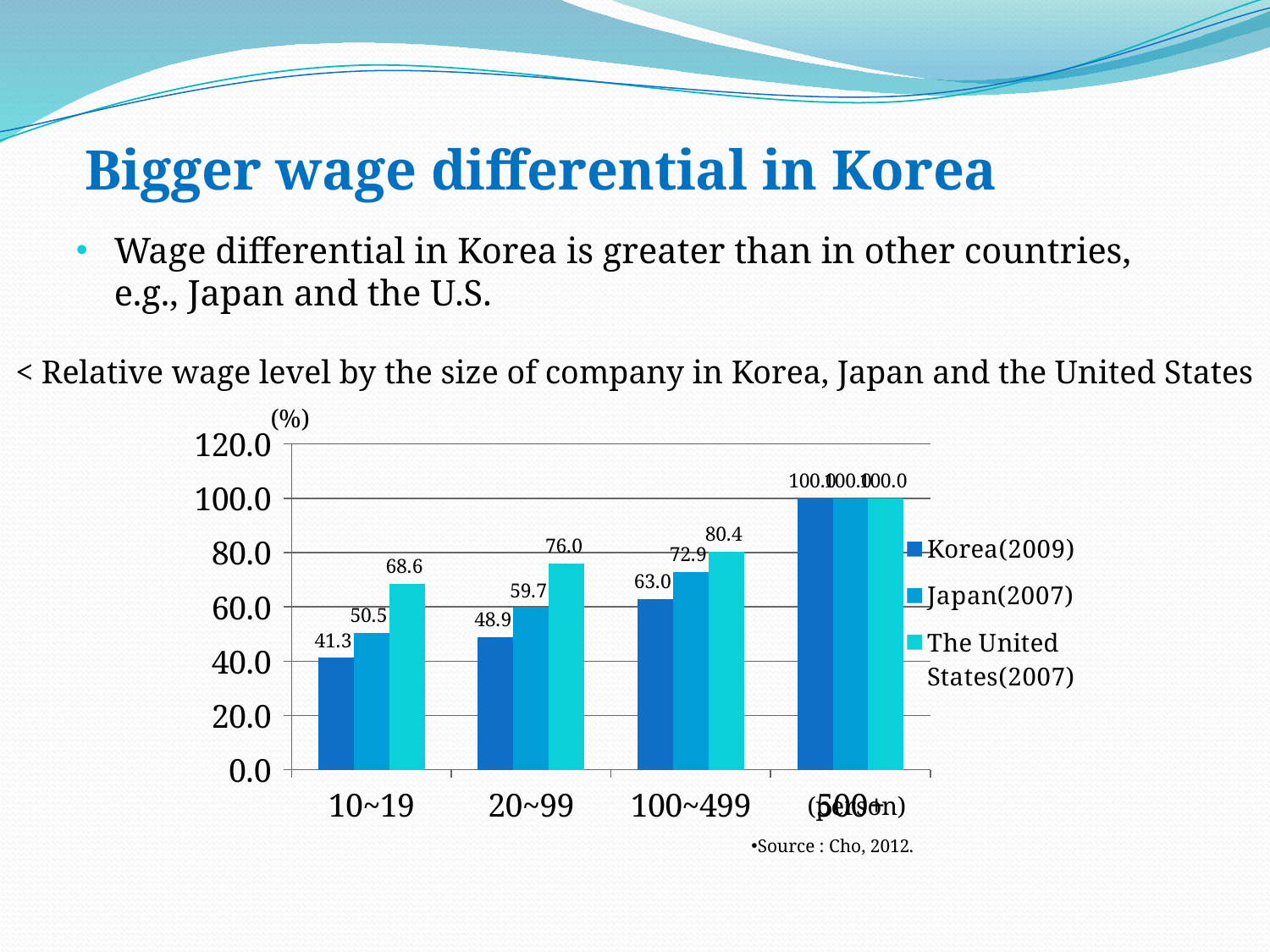
Which is larger: the Korea(2009) value for 20~99 or the Japan(2007) value for 10~19? Japan(2007) value for 10~19 What is the difference between Japan(2007) and Korea(2009) values in the 100~499 category? 9.9 What is the difference between The United States(2007) and Korea(2009) values in the 10~19 category? 27.3 What kind of chart is shown on the slide? Bar chart Do the Korea(2009) values rise or fall as company size increases along the x axis? Rise What is the value for Korea(2009) in the 10~19 category? 41.3 Which series has the highest value in the 100~499 category? The United States(2007) What is the value for Japan(2007) in the 100~499 category? 72.9 How many series does the legend list? 3 Which series has the lowest value in the 10~19 category? Korea(2009) What is the value for Japan(2007) in the 20~99 category? 59.7 What is the value for The United States(2007) in the 20~99 category? 76.0